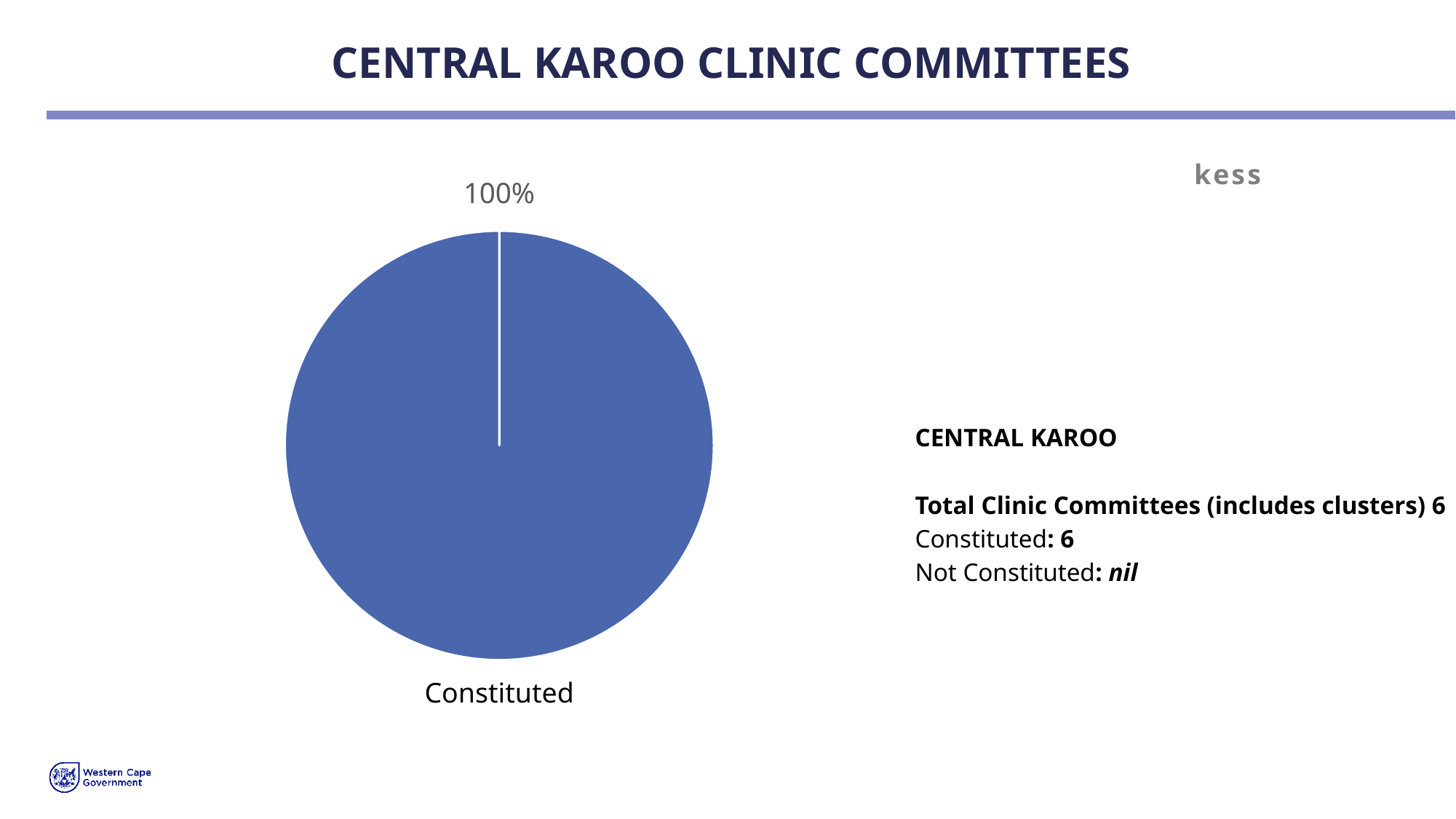
What is the title of the slide containing the pie chart? CENTRAL KAROO CLINIC COMMITTEES How many slices does the pie chart have? 1 What is the data label shown on the pie chart? 100% What kind of chart is shown on the slide? pie chart Is the share for Constituted greater or less than 50%? greater What share of the pie does the Constituted slice represent? 100% What is the label of the only slice in the pie chart? Constituted